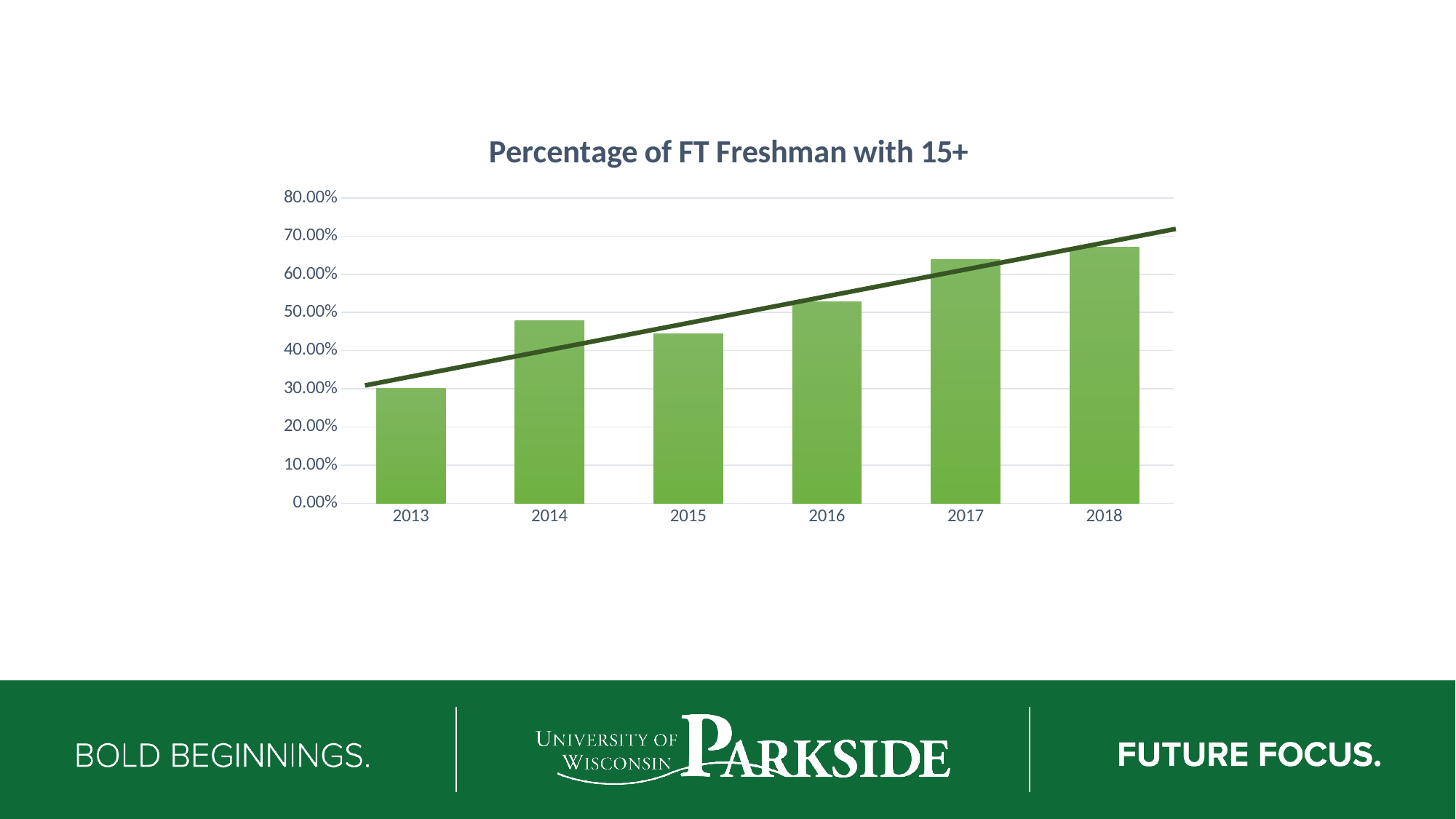
Is the value for 2013 greater or less than 40.00%? less Which year has a higher value, 2014 or 2015? 2014 What kind of chart is shown on the slide? Bar chart Which year has the lowest percentage of FT freshman with 15+? 2013 Do the values generally rise or fall from 2013 to 2018? Rise Is the value for 2016 greater or less than 50.00%? greater Is the value for 2014 greater or less than 40.00%? greater How many years are shown on the x axis of the chart? 6 What is the title of the chart? Percentage of FT Freshman with 15+ Which year has the highest percentage of FT freshman with 15+? 2018